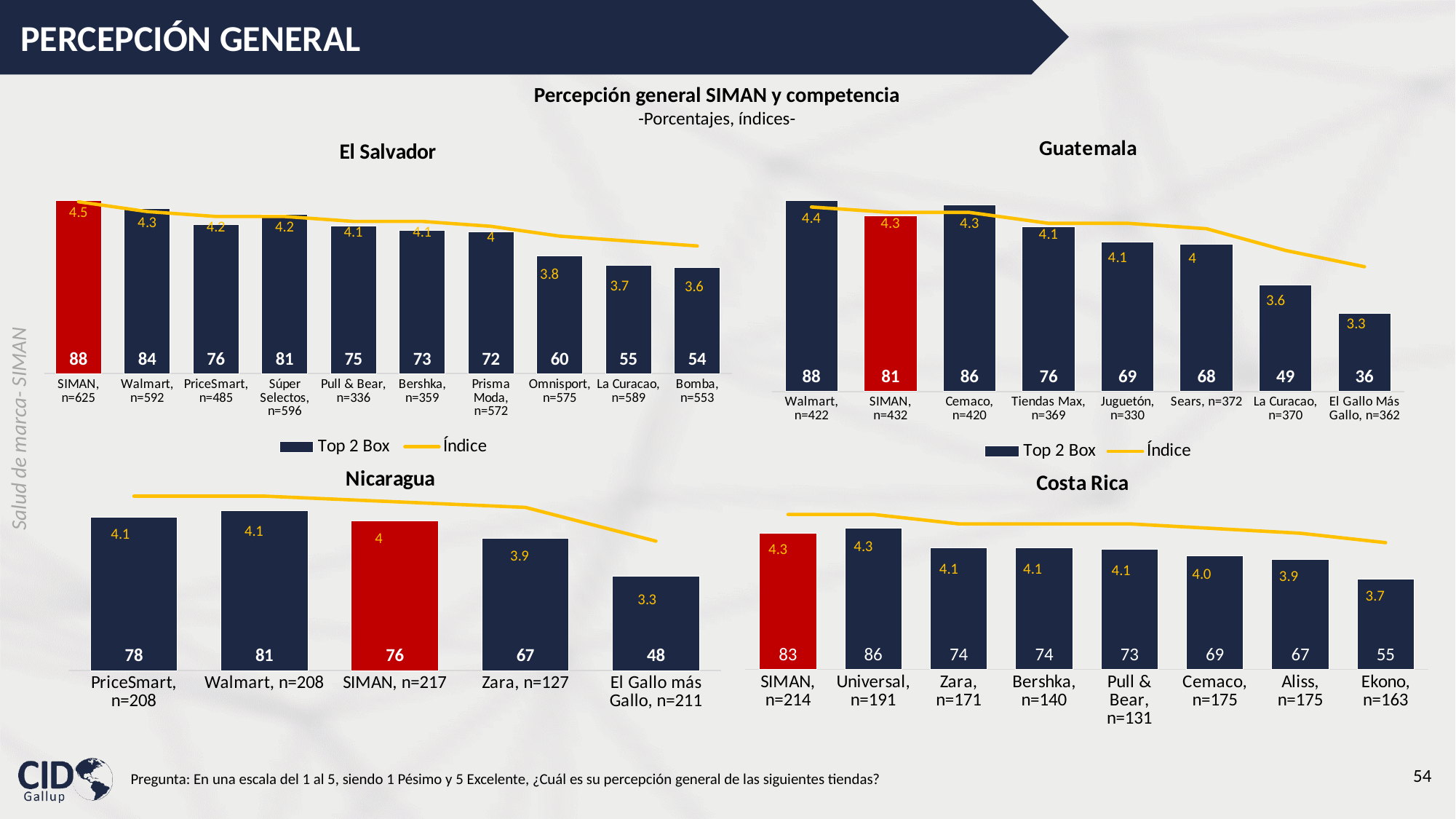
In the El Salvador chart, what is the Top 2 Box value for SIMAN? 88 In the Guatemala chart, what is the difference between the Top 2 Box values of Walmart and SIMAN? 7 In the Costa Rica chart, what is the Índice value for Ekono? 3.7 In the Costa Rica chart, what is the Top 2 Box value for Universal? 86 How many stores are shown in the Nicaragua chart? 5 In the Guatemala chart, what is the Índice value for El Gallo Más Gallo? 3.3 In the Guatemala chart, which store has the highest Top 2 Box value? Walmart In the El Salvador chart, what is the Índice value for Omnisport? 3.8 What type of chart is used for the Top 2 Box values in the Guatemala chart? Bar chart In the El Salvador chart, which store has the lowest Top 2 Box value? Bomba In the Nicaragua chart, which has a higher Top 2 Box value, PriceSmart or Walmart? Walmart How many series does the legend of the El Salvador chart list? 2